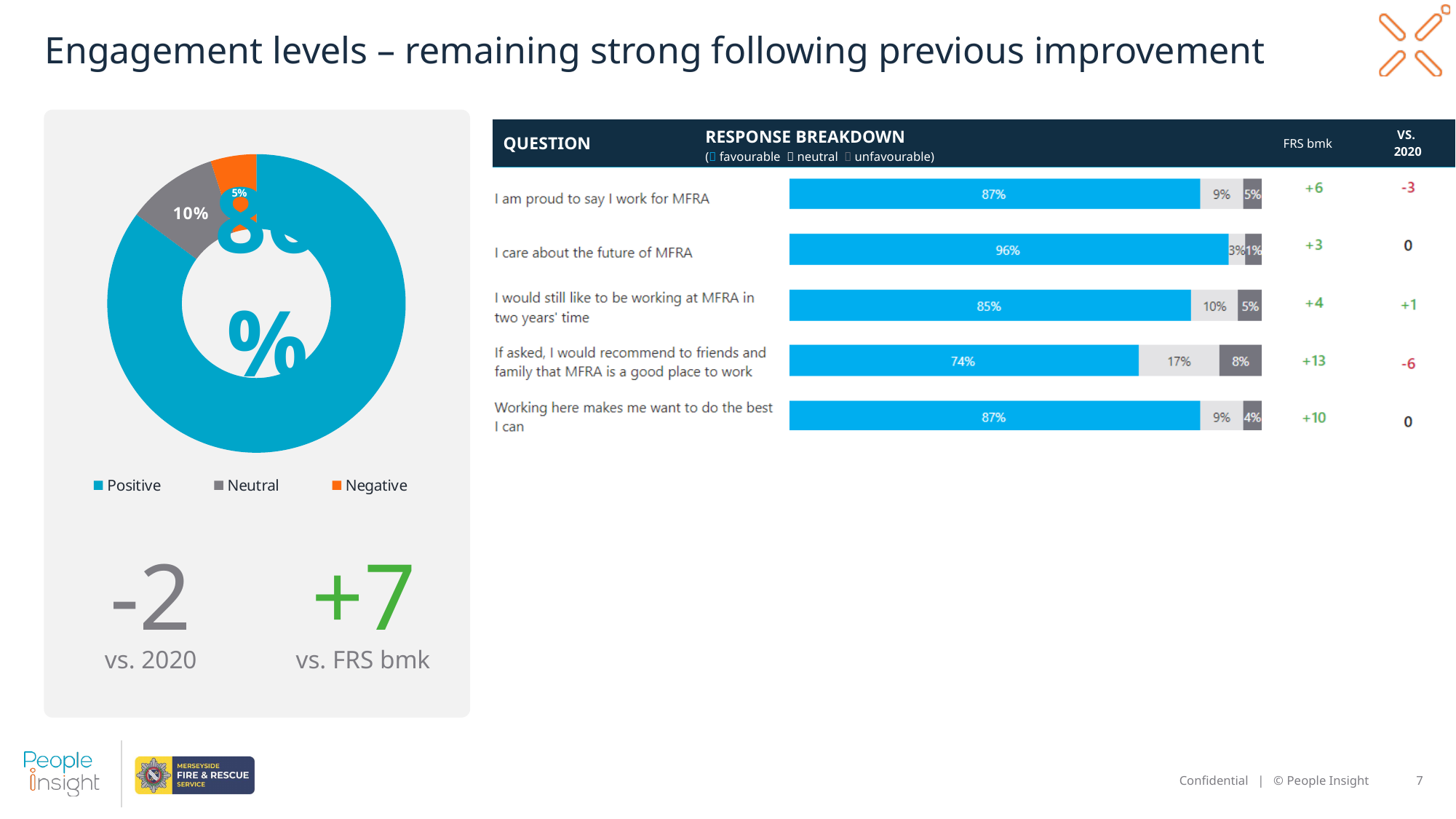
What kind of chart is the Response Breakdown chart? Stacked bar chart How many questions are plotted in the Response Breakdown chart? 5 In the donut chart on the left, what share of responses is Negative? 5% In the Response Breakdown chart, what is the favourable percentage for 'I care about the future of MFRA'? 96% In the Response Breakdown chart, what is the difference between the highest and lowest favourable percentages? 22 percentage points In the Response Breakdown chart, which question has the highest favourable percentage? I care about the future of MFRA In the donut chart on the left, what share of responses is Neutral? 10% In the donut chart on the left, which category is the largest? Positive What kind of chart is shown on the left of the slide? Pie (donut) chart How many entries does the legend of the donut chart on the left list? 3 In the Response Breakdown chart, which question has the lowest favourable percentage? If asked, I would recommend to friends and family that MFRA is a good place to work In the Response Breakdown chart, what is the unfavourable percentage for 'If asked, I would recommend to friends and family that MFRA is a good place to work'? 8%